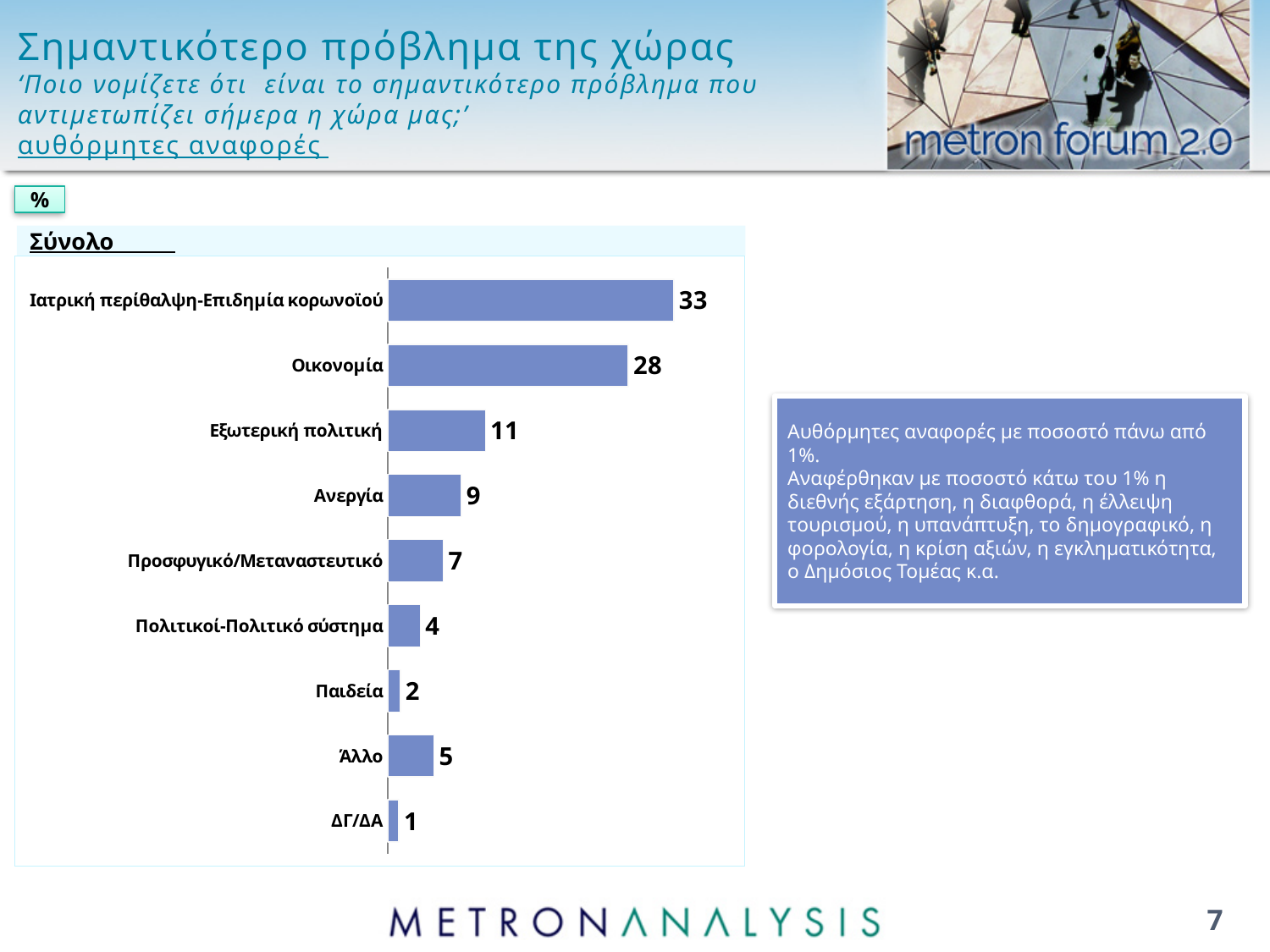
How many categories are shown in the chart? 9 Which category has the lowest value? ΔΓ/ΔΑ What is the heading shown above the chart? Σύνολο What value is shown for Ανεργία? 9 Which is larger, the value for Άλλο or the value for Πολιτικοί-Πολιτικό σύστημα? Άλλο Which is larger, the value for Εξωτερική πολιτική or the value for Ανεργία? Εξωτερική πολιτική What value is shown for Προσφυγικό/Μεταναστευτικό? 7 Which category has the highest value? Ιατρική περίθαλψη-Επιδημία κορωνοϊού What is the difference between the values for Ιατρική περίθαλψη-Επιδημία κορωνοϊού and Οικονομία? 5 What is the difference between the values for Παιδεία and ΔΓ/ΔΑ? 1 What kind of chart is shown on the slide? bar chart What value is shown for Οικονομία? 28